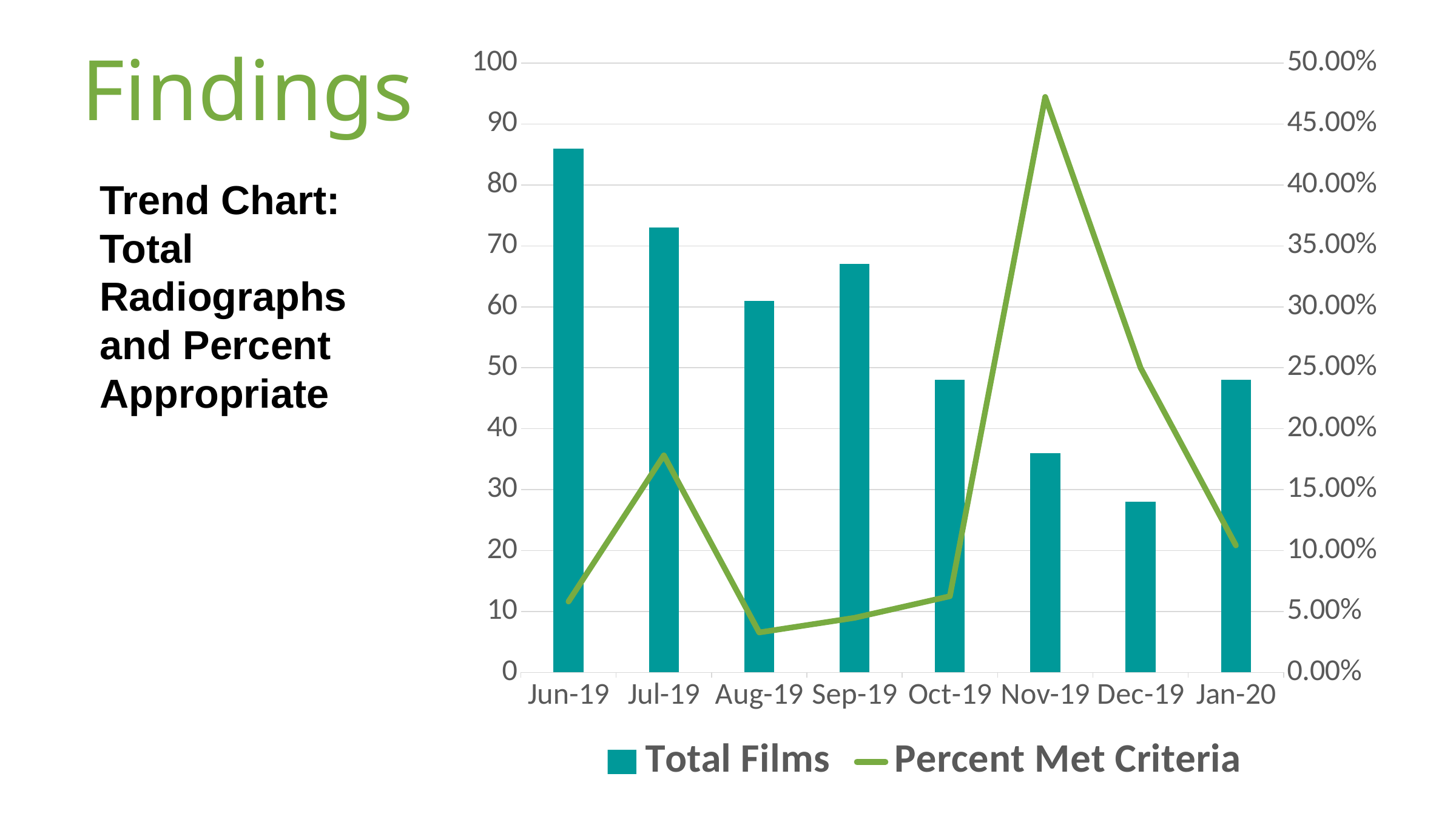
Is the Percent Met Criteria value for Nov-19 greater or less than 45.00%? greater Which month has the highest Total Films bar? Jun-19 Which month has more Total Films, Jul-19 or Sep-19? Jul-19 Which month has a higher Percent Met Criteria, Nov-19 or Dec-19? Nov-19 Is the Total Films value for Dec-19 greater or less than 30? less In which month does the Percent Met Criteria line reach its highest point? Nov-19 How many series does the chart legend list? 2 Which month has the lowest Total Films bar? Dec-19 Is the Total Films value for Jun-19 greater or less than 80? greater Does the Total Films series generally rise or fall from Jun-19 to Dec-19? fall How many months are shown on the x axis of the chart? 8 What kind of chart is shown on the slide? Combined bar and line chart